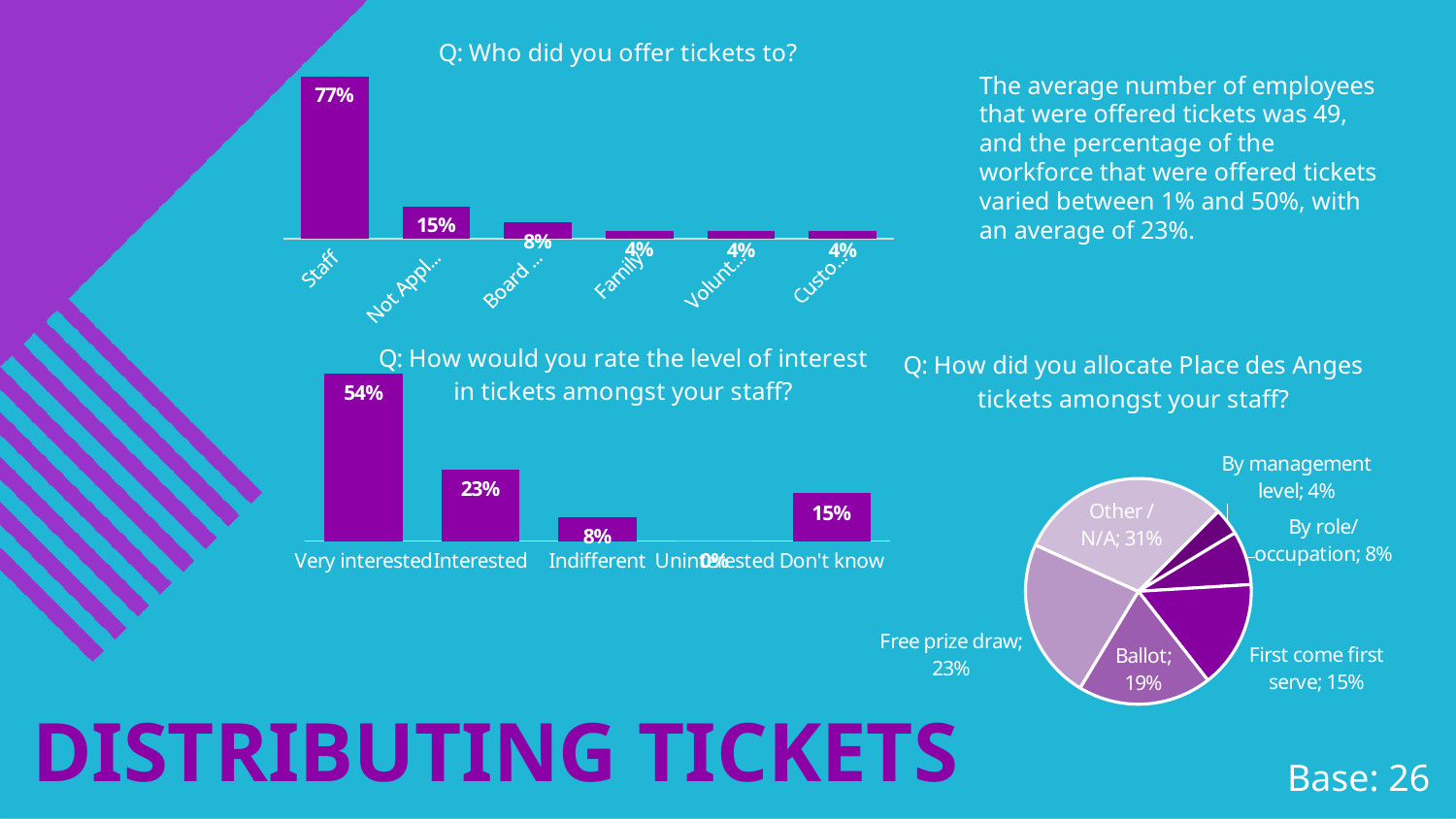
In the chart 'Q: Who did you offer tickets to?', which category has the highest value? Staff In the chart 'Q: Who did you offer tickets to?', what is the difference between the Staff value and the Family value? 73 percentage points In the chart 'Q: Who did you offer tickets to?', what percentage is shown for Staff? 77% How many slices does the pie chart 'Q: How did you allocate Place des Anges tickets amongst your staff?' have? 6 What type of chart is 'Q: How would you rate the level of interest in tickets amongst your staff?'? Bar chart In the chart 'Q: How would you rate the level of interest in tickets amongst your staff?', which is larger: Interested or Don't know? Interested In the chart 'Q: How would you rate the level of interest in tickets amongst your staff?', which category has the lowest value? Uninterested In the chart 'Q: How would you rate the level of interest in tickets amongst your staff?', what percentage is shown for Very interested? 54% In the chart 'Q: How would you rate the level of interest in tickets amongst your staff?', what is the difference between Very interested and Interested? 31 percentage points In the pie chart 'Q: How did you allocate Place des Anges tickets amongst your staff?', what share is Ballot? 19% In the pie chart 'Q: How did you allocate Place des Anges tickets amongst your staff?', which slice is the largest? Other / N/A How many categories are shown in the chart 'Q: Who did you offer tickets to?'? 6